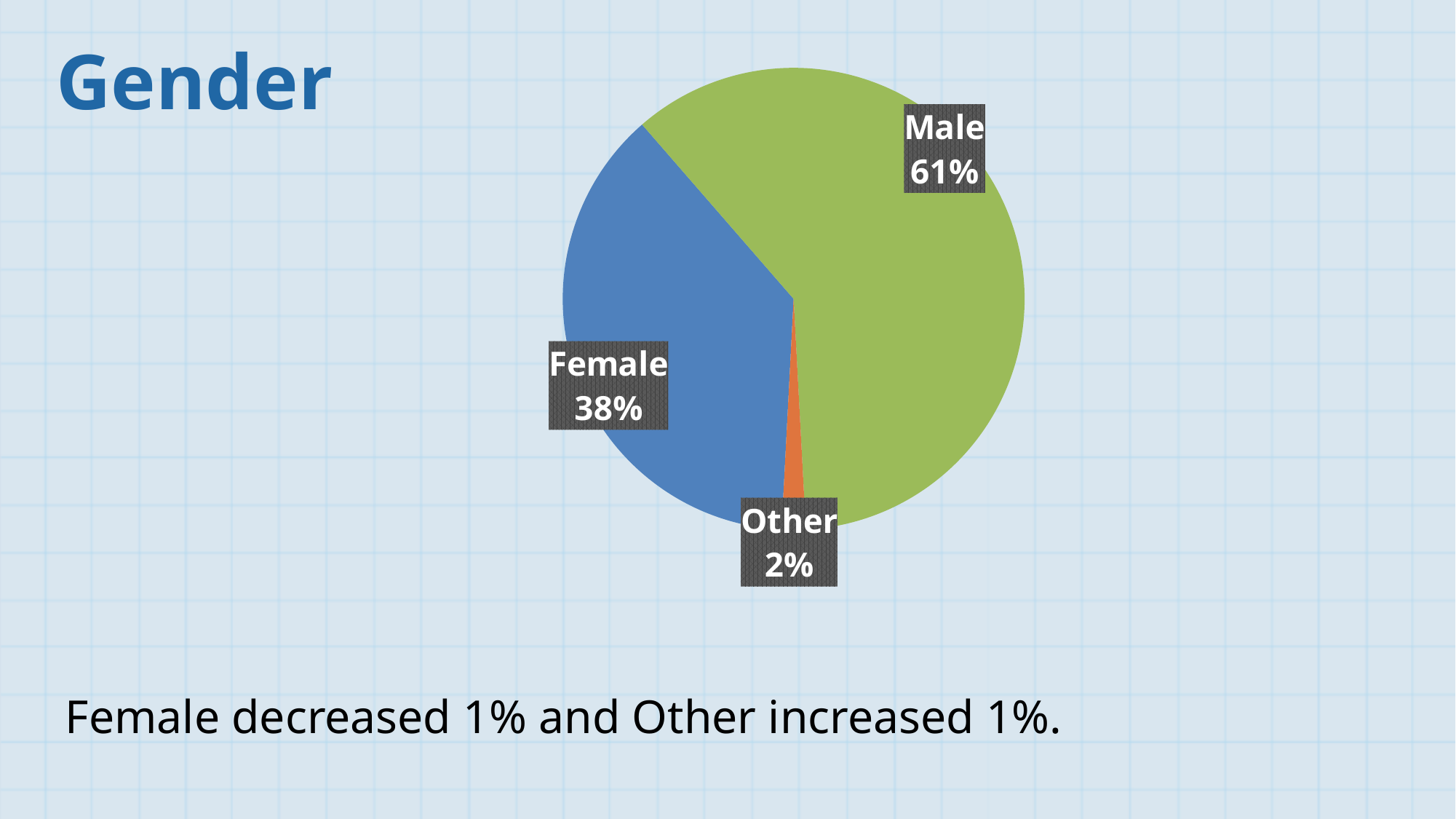
What is the difference in percentage points between the Male and Female slices? 23 What percentage of the pie is Male? 61% What is the difference in percentage points between the Female and Other slices? 36 What kind of chart is shown on the slide? pie chart Which category has the smallest slice of the pie? Other What colour is the Male slice of the pie chart? green What percentage of the pie is Other? 2% What percentage of the pie is Female? 38% Which is larger, the Female slice or the Other slice? Female Which category has the largest slice of the pie? Male How many slices does the pie chart have? 3 What is the title of the slide containing the pie chart? Gender